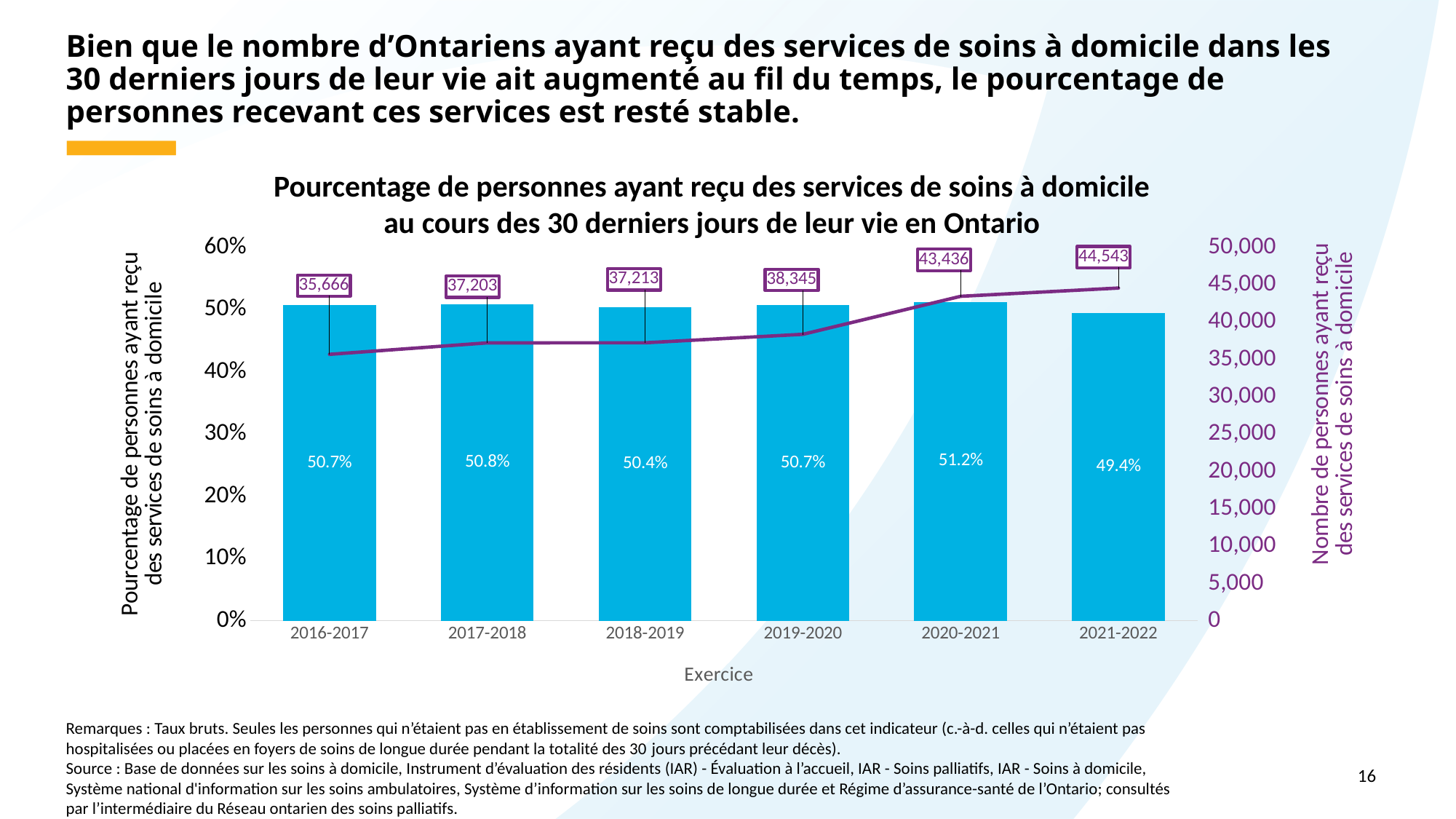
What percentage of people received home care services in the last 30 days of life in 2016-2017? 50.7% Is the number of people receiving home care services larger in 2019-2020 or in 2020-2021? 2020-2021 What is the number of people who received home care services in 2018-2019? 37,213 Which fiscal year has the lowest number of people receiving home care services? 2016-2017 What is the label of the x axis? Exercice Does the number of people receiving home care services rise or fall from 2016-2017 to 2021-2022? rise Which fiscal year has the lowest percentage of people receiving home care services? 2021-2022 Which fiscal year has the highest percentage of people receiving home care services? 2020-2021 What is the difference in the number of people receiving home care services between 2021-2022 and 2016-2017? 8,877 What is the number of people who received home care services in 2021-2022? 44,543 What is the difference in percentage points between 2020-2021 and 2021-2022? 1.8 How many fiscal years are shown on the x axis? 6